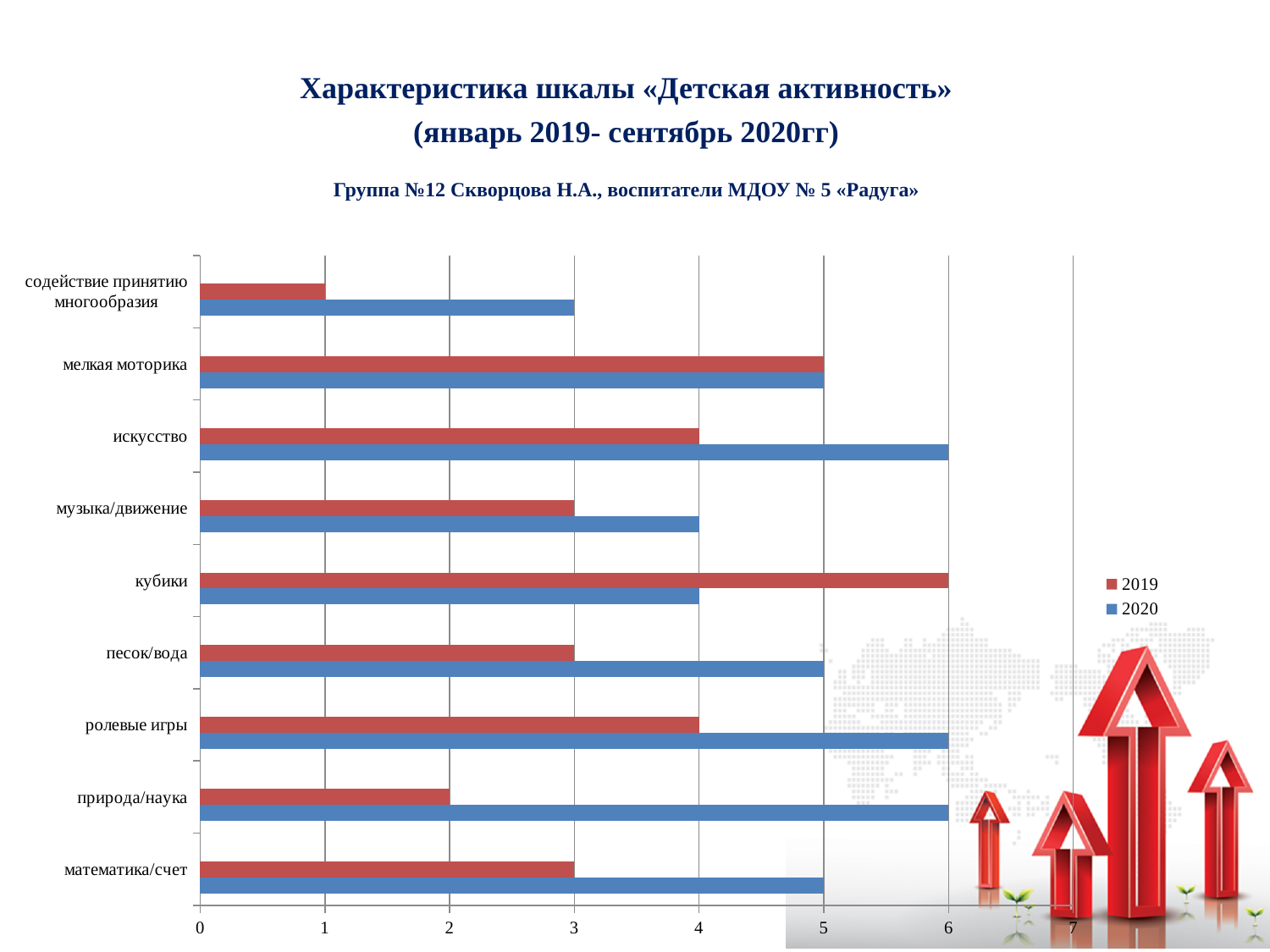
What is the 2019 value for кубики? 6 What kind of chart is shown on the slide? bar chart Which category has the highest 2019 value? кубики How many series does the legend list? 2 What is the 2019 value for содействие принятию многообразия? 1 Which series is shown in red in the legend? 2019 Is the 2020 value for ролевые игры greater or less than 5? greater What is the 2020 value for природа/наука? 6 For кубики, which is larger: the 2019 value or the 2020 value? 2019 Which category has the lowest 2020 value? содействие принятию многообразия What is the difference between the 2020 and 2019 values for природа/наука? 4 How many categories are shown on the chart? 9